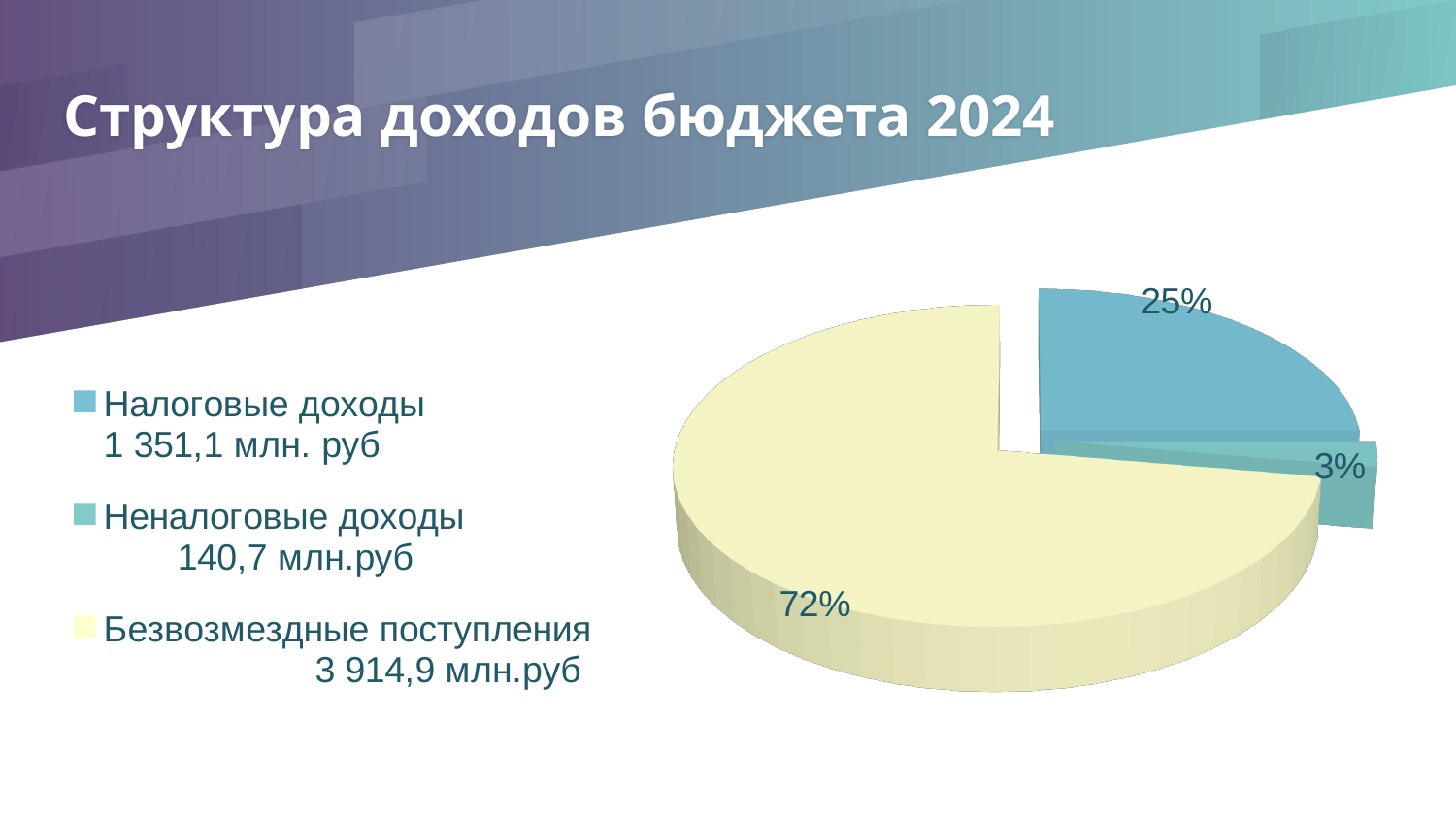
What amount is shown in the legend for Налоговые доходы? 1 351,1 млн. руб Which category has the largest share of the pie? Безвозмездные поступления What kind of chart is shown on the slide? Pie chart What share of the pie does Безвозмездные поступления represent? 72% What share of the pie does Неналоговые доходы represent? 3% What is the title of the chart on the slide? Структура доходов бюджета 2024 What share of the pie does Налоговые доходы represent? 25% Which category has the smallest share of the pie? Неналоговые доходы By how many percentage points does the share of Безвозмездные поступления exceed the share of Налоговые доходы? 47% What amount is shown in the legend for Неналоговые доходы? 140,7 млн.руб What amount is shown in the legend for Безвозмездные поступления? 3 914,9 млн.руб How many slices does the pie chart have? 3